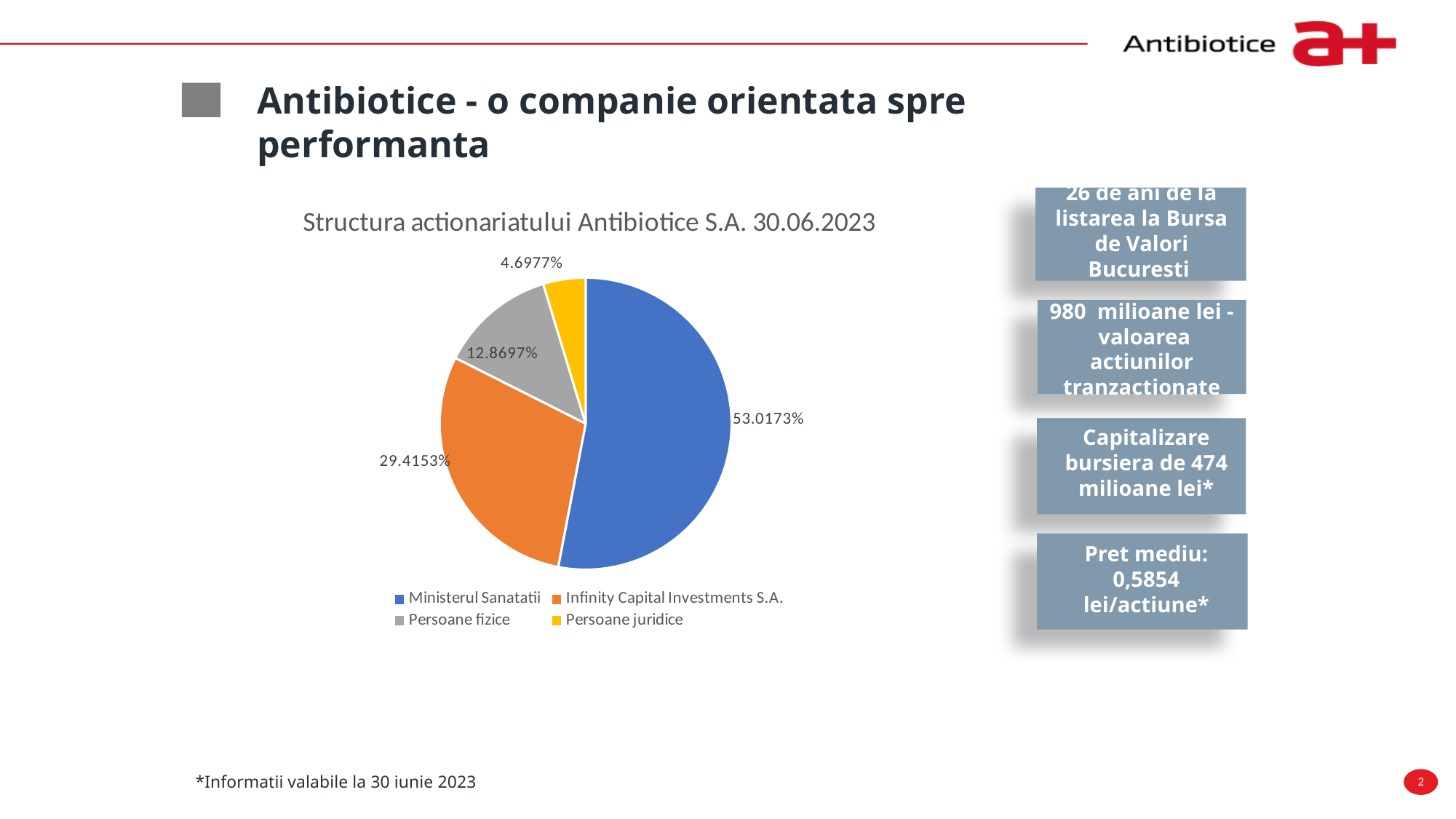
What share of the shareholding is held by Persoane juridice? 4.6977% Which holds a larger share: Persoane fizice or Persoane juridice? Persoane fizice How many shareholder categories does the legend list? 4 What type of chart is shown on the slide? Pie chart Which shareholder category has the smallest slice of the pie? Persoane juridice What share of the shareholding does Infinity Capital Investments S.A. hold? 29.4153% What colour is the slice for Infinity Capital Investments S.A.? Orange What share of the shareholding is held by Persoane fizice? 12.8697% What is the title of the pie chart? Structura actionariatului Antibiotice S.A. 30.06.2023 Which shareholder category has the largest slice of the pie? Ministerul Sanatatii What is the difference in percentage points between the Ministerul Sanatatii share and the Infinity Capital Investments S.A. share? 23.6020% What share of the shareholding does Ministerul Sanatatii hold? 53.0173%